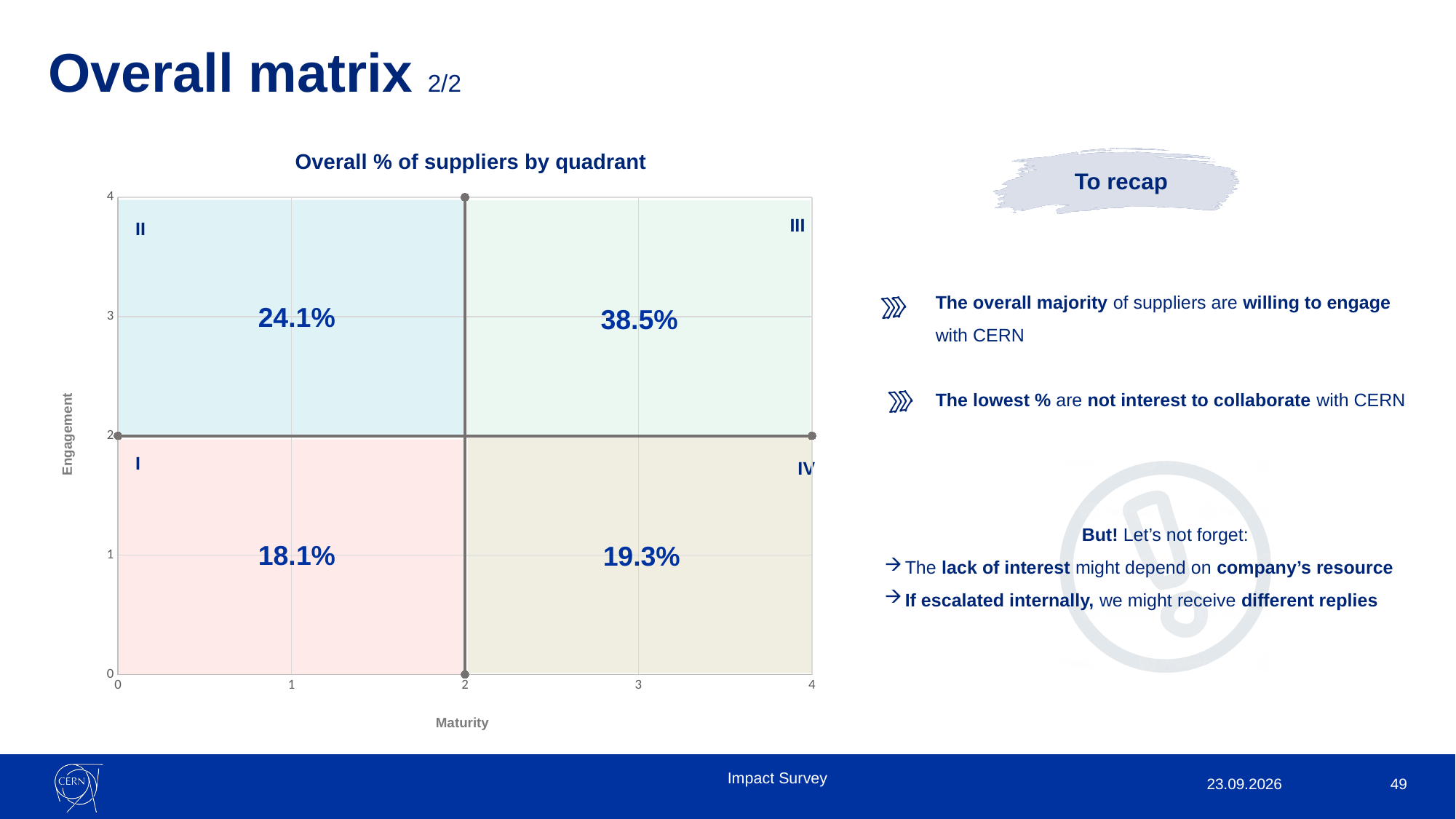
What percentage of suppliers falls in quadrant III? 38.5% How many quadrants are shown in the matrix? 4 Which has a larger share of suppliers, quadrant II or quadrant IV? Quadrant II What are the labels of the x axis and the y axis of the chart? Maturity (x axis) and Engagement (y axis) What is the title of the chart on the slide? Overall % of suppliers by quadrant What percentage of suppliers falls in quadrant II? 24.1% Which quadrant has the highest percentage of suppliers? III What percentage of suppliers falls in quadrant IV? 19.3% What is the difference in percentage points between quadrant III and quadrant II? 14.4 Which quadrant has the lowest percentage of suppliers? I What is the difference in percentage points between quadrant IV and quadrant I? 1.2 What percentage of suppliers falls in quadrant I? 18.1%